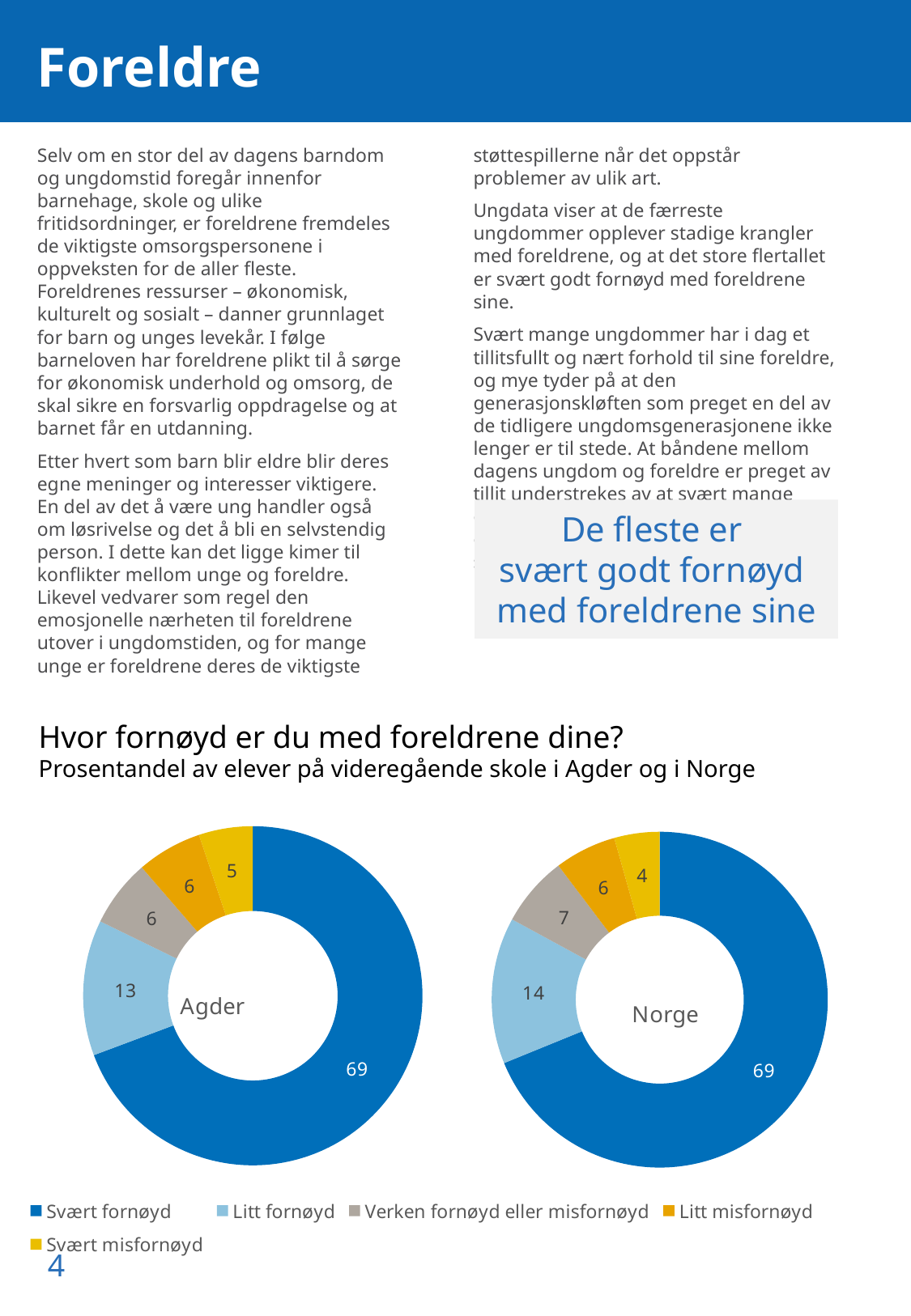
What is the difference between the 'Litt fornøyd' values in the Norge chart and the Agder chart? 1 What is the title of the chart section on the slide? Hvor fornøyd er du med foreldrene dine? In the Agder chart, what is the combined share of 'Litt misfornøyd' and 'Svært misfornøyd'? 11 In the Norge chart, what is the value for 'Verken fornøyd eller misfornøyd'? 7 How many categories does the legend list for the charts? 5 In the Norge chart, what percentage of students answered 'Litt fornøyd'? 14 Which is larger: 'Svært misfornøyd' in the Agder chart or 'Svært misfornøyd' in the Norge chart? Agder In the Agder chart, which category has the largest share? Svært fornøyd In the Norge chart, which category has the smallest share? Svært misfornøyd In the Agder chart, what is the value for 'Svært misfornøyd'? 5 What kind of chart is used to show the Agder and Norge data? Doughnut (pie) chart In the Agder chart, what percentage of students answered 'Svært fornøyd'? 69